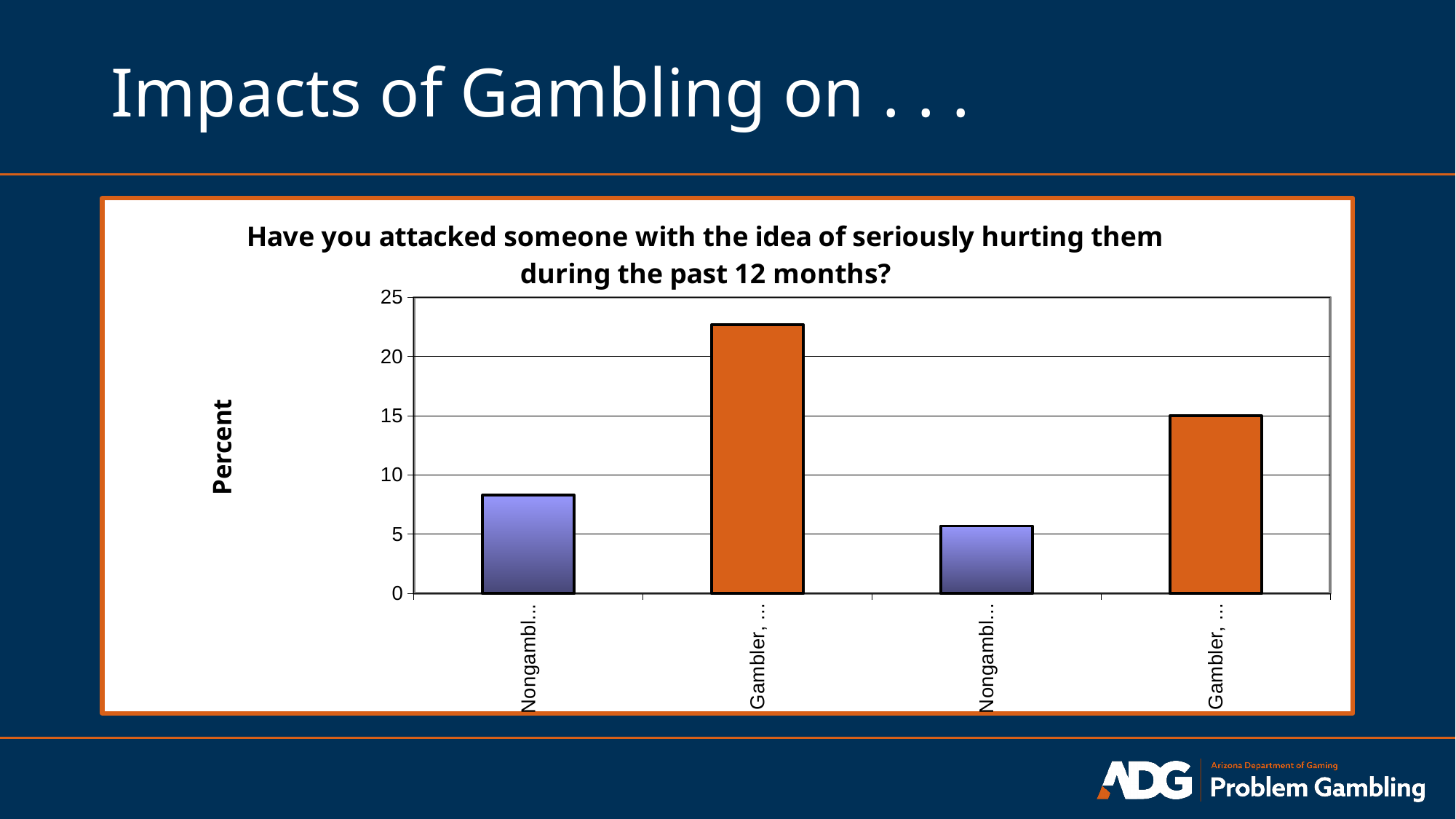
Is the value for the third bar (Nongambler) greater or less than 10? less Which bar is the shortest in the chart? the third bar (Nongambler) Is the value for the first bar (Nongambler) greater or less than 10? less Is the value for the second bar (Gambler) greater or less than 20? greater What kind of chart is shown on the slide? bar chart What is the label on the vertical axis of the chart? Percent What is the title of the chart? Have you attacked someone with the idea of seriously hurting them during the past 12 months? Which is larger, the value for the first bar or the value for the third bar? the first bar Which bar is the tallest in the chart? the second bar (Gambler) Which is larger, the value for the second bar or the value for the fourth bar? the second bar How many bars are plotted in the chart? 4